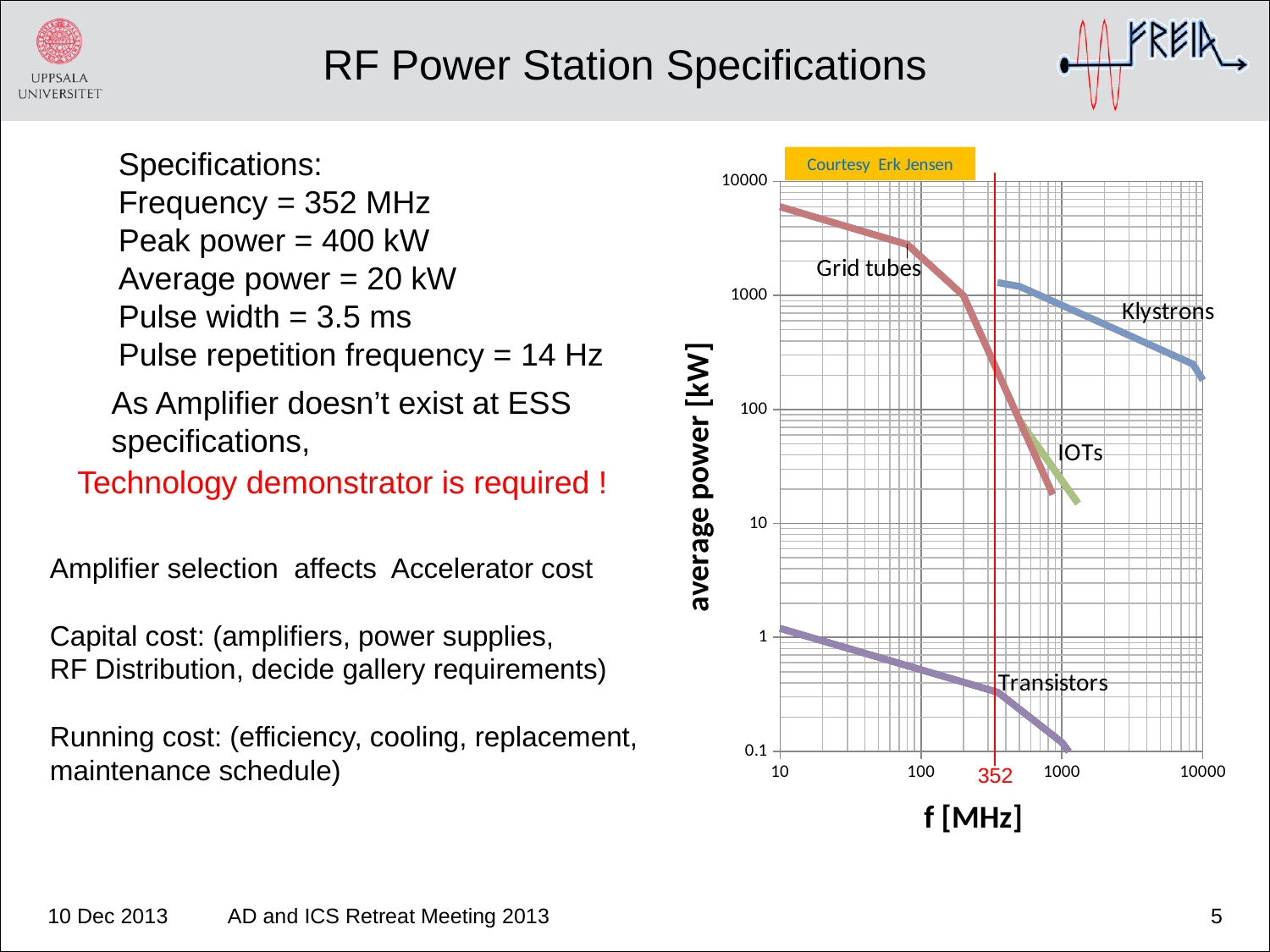
What is the label of the x axis of the chart? f [MHz] At 1000 MHz, which curve shows higher average power, Klystrons or IOTs? Klystrons Is the average power of Klystrons at 10000 MHz greater or less than 1000 kW? less Does the average power of Klystrons rise or fall as frequency increases? fall Does the average power of Grid tubes rise or fall as frequency increases? fall How many amplifier technology curves are labelled on the chart? 4 What is the label of the y axis of the chart? average power [kW] Is the average power of Transistors at 1000 MHz greater or less than 1 kW? less What kind of chart is shown on the slide? line chart What frequency is marked by the red vertical line on the chart? 352 Is the average power of IOTs at 1000 MHz greater or less than 100 kW? less